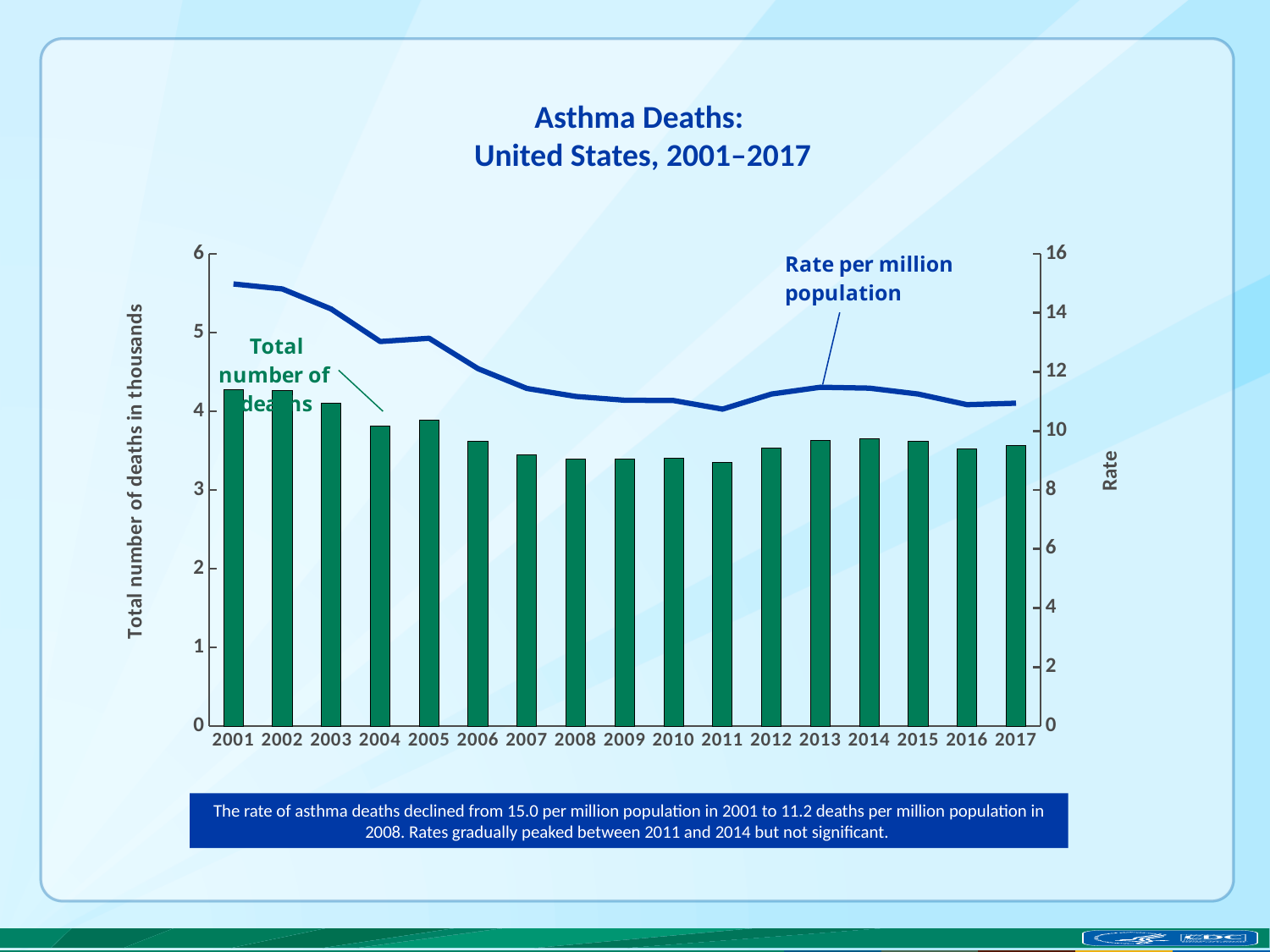
How many data series are plotted on the chart? 2 How many years are shown on the x axis? 17 What is the title of the chart? Asthma Deaths: United States, 2001–2017 Is the total number of deaths (in thousands) for 2001 greater or less than 4? greater Did the rate per million population rise or fall between 2001 and 2008? Fall What was the rate of asthma deaths per million population in 2008? 11.2 By how much did the rate per million population decline from 2001 to 2008? 3.8 What kind of chart is used to show the total number of deaths? Bar chart What was the rate of asthma deaths per million population in 2001? 15.0 Is the total number of deaths (in thousands) for 2004 greater or less than 4? less Is the rate per million population in 2011 greater or less than 12? less Which year had a larger total number of deaths, 2001 or 2011? 2001